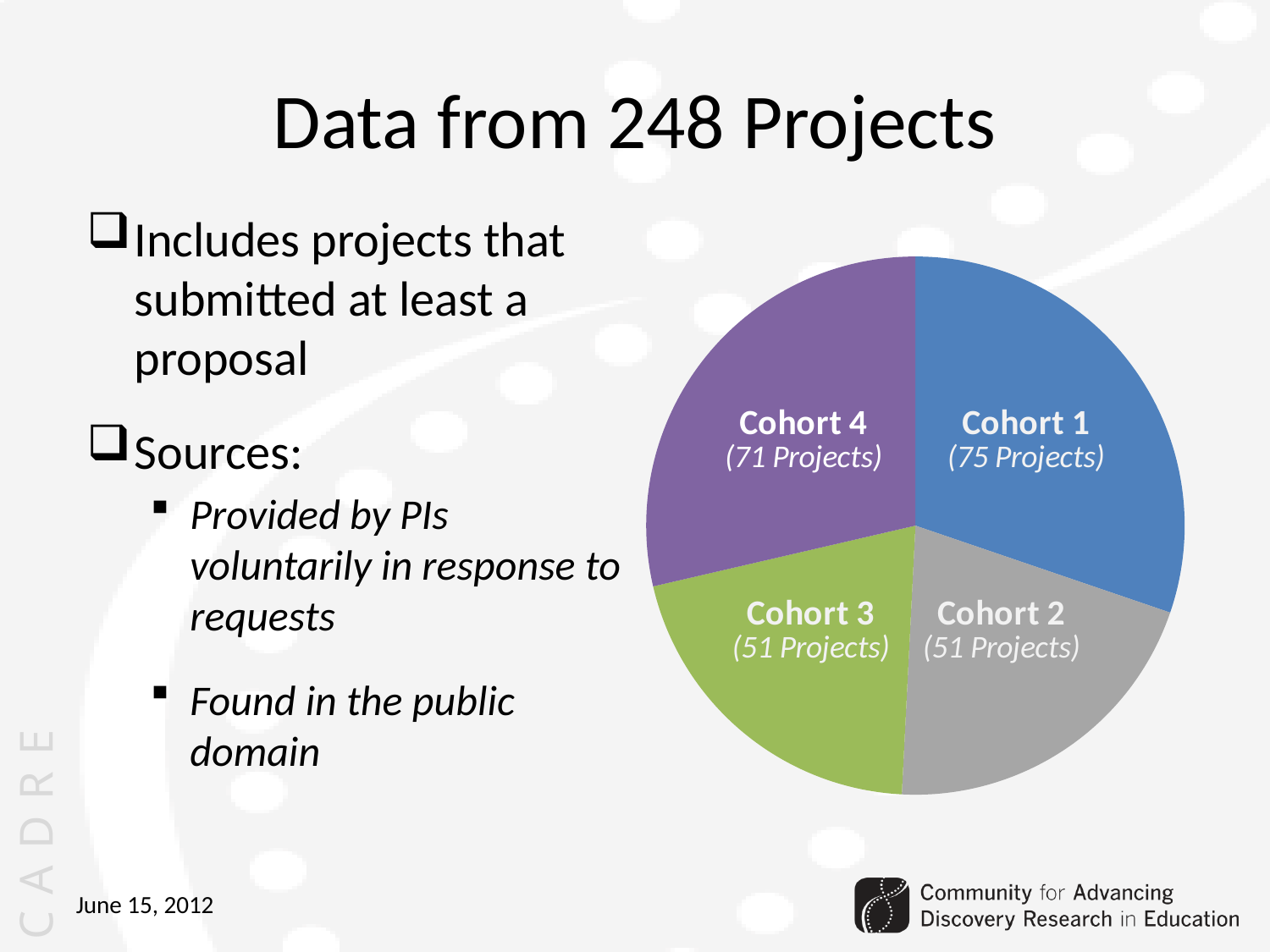
What colour is the Cohort 4 slice of the pie chart? Purple How many more projects does Cohort 1 have than Cohort 4? 4 Which cohort has the largest number of projects in the pie chart? Cohort 1 How many projects are in Cohort 3? 51 Projects How many cohorts (slices) are shown in the pie chart? 4 What is the difference in projects between Cohort 4 and Cohort 2? 20 Which two cohorts have the same number of projects? Cohort 2 and Cohort 3 How many projects does the pie chart show for Cohort 4? 71 Projects Which has more projects, Cohort 1 or Cohort 4? Cohort 1 How many projects are in Cohort 2? 51 Projects How many projects are in Cohort 1 according to the pie chart? 75 Projects What type of chart is shown on the slide? Pie chart